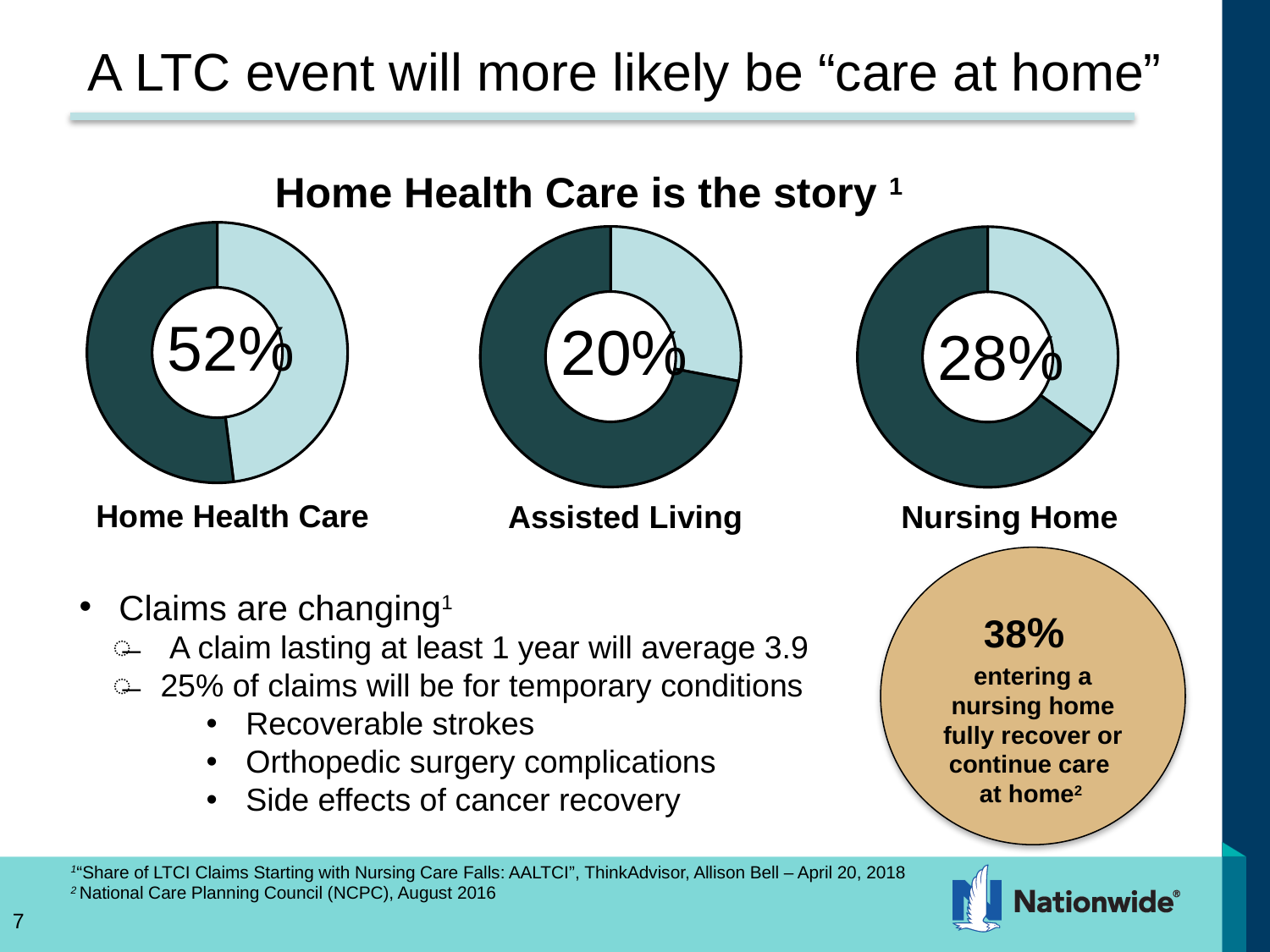
Which has a larger percentage, Nursing Home or Assisted Living? Nursing Home What is the difference in percentage points between the Home Health Care chart and the Nursing Home chart? 24 What percentage is shown in the Home Health Care donut chart? 52% How many donut charts are shown on the slide? 3 Which of the three care settings shown in the donut charts has the lowest percentage? Assisted Living Which has a larger percentage, Home Health Care or Nursing Home? Home Health Care What is the heading printed above the three donut charts? Home Health Care is the story What type of chart is used to show the Home Health Care, Assisted Living and Nursing Home percentages? Donut chart What percentage is shown in the Nursing Home donut chart? 28% What percentage is shown in the Assisted Living donut chart? 20% What is the difference in percentage points between the Nursing Home chart and the Assisted Living chart? 8 Which of the three care settings shown in the donut charts has the highest percentage? Home Health Care